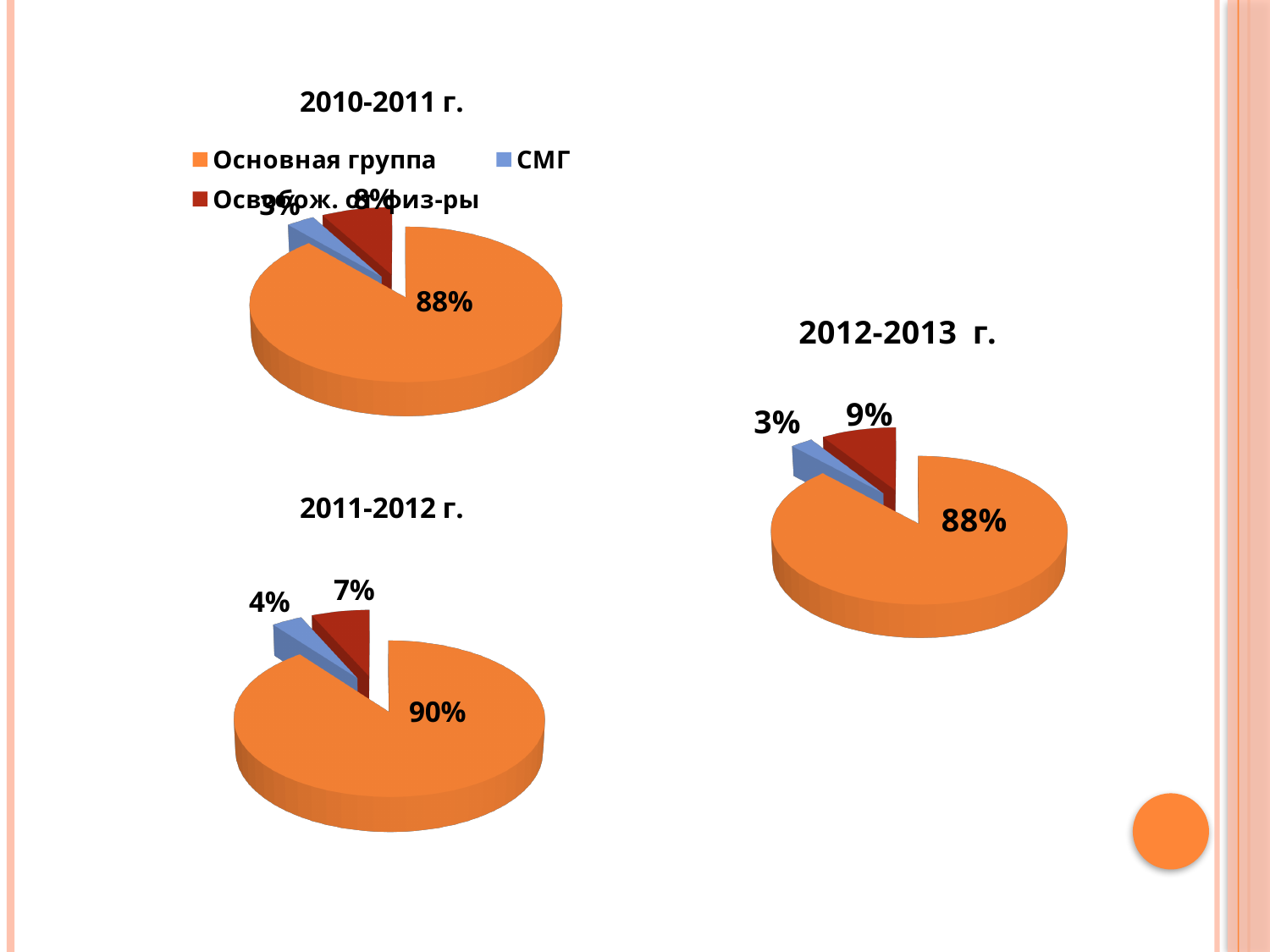
In the 2011-2012 г. chart, what share does the blue slice (СМГ) have? 4% How many slices does the 2011-2012 г. pie chart have? 3 In the 2012-2013 г. chart, what share does the blue slice (СМГ) have? 3% In the 2011-2012 г. chart, which category has the smallest slice? СМГ In the 2011-2012 г. chart, what share does the orange slice (Основная группа) have? 90% In the 2012-2013 г. chart, what share does the red slice (Освобож. от физ-ры) have? 9% How many entries does the legend of the 2010-2011 г. chart list? 3 In the 2010-2011 г. chart, what share does Основная группа have? 88% In the 2011-2012 г. chart, what share does the red slice (Освобож. от физ-ры) have? 7% In the 2012-2013 г. chart, which category has the largest slice? Основная группа What kind of chart is used for the 2011-2012 г. data? pie chart In the 2012-2013 г. chart, what is the difference between the red slice (9%) and the blue slice (3%)? 6%